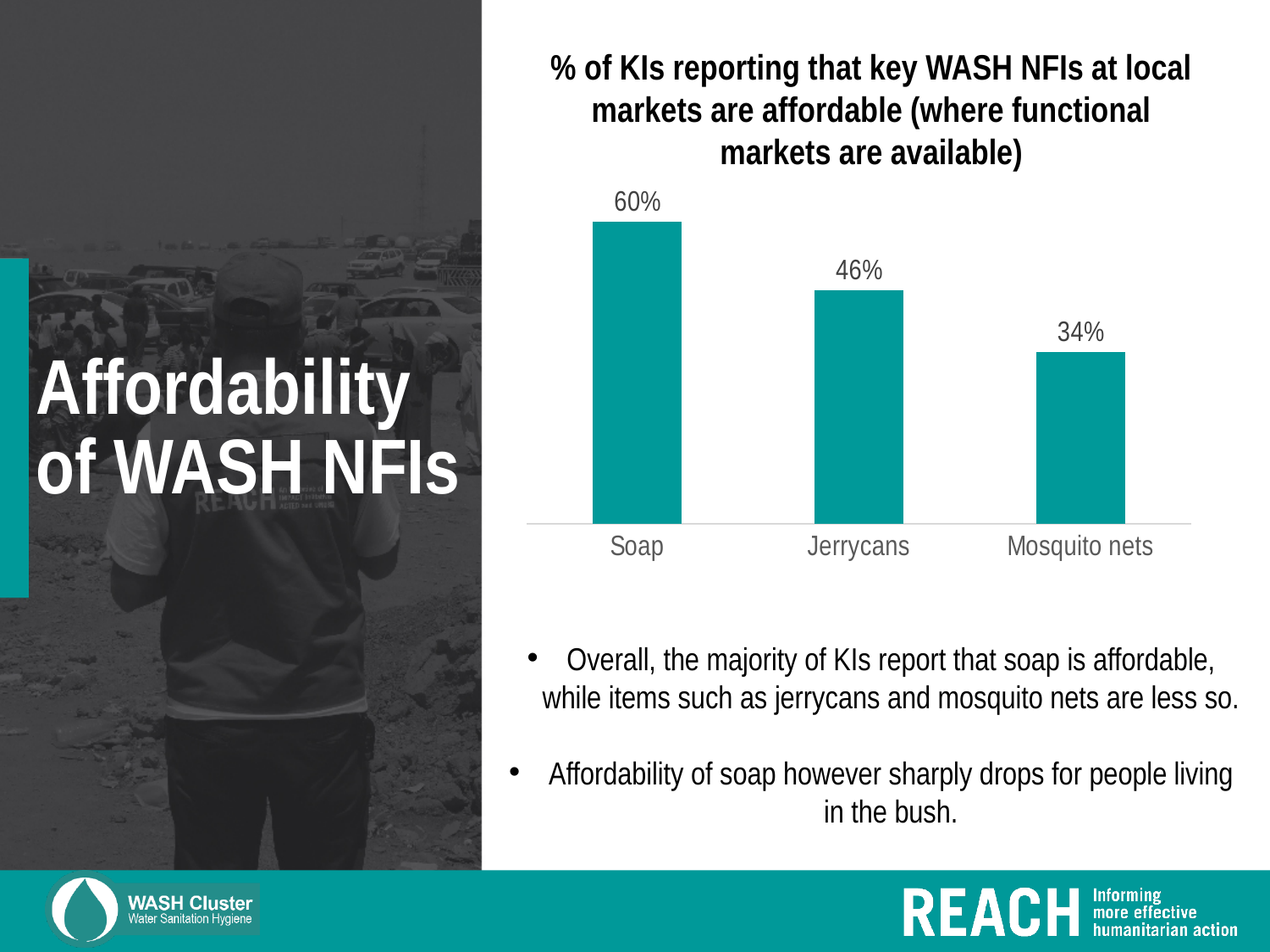
Which item has the highest percentage of KIs reporting it as affordable? Soap What percentage of KIs report that mosquito nets are affordable? 34% What type of chart is shown on the slide? Bar chart How many items are shown on the chart? 3 What is the difference in percentage points between the values for soap and mosquito nets? 26 percentage points Which item has the lowest percentage of KIs reporting it as affordable? Mosquito nets What is the title of the chart? % of KIs reporting that key WASH NFIs at local markets are affordable (where functional markets are available) Do the values rise or fall from left to right across the chart? Fall Which has a higher value, jerrycans or mosquito nets? Jerrycans What is the difference in percentage points between the values for jerrycans and mosquito nets? 12 percentage points What percentage of KIs report that jerrycans are affordable? 46% What percentage of KIs report that soap is affordable? 60%